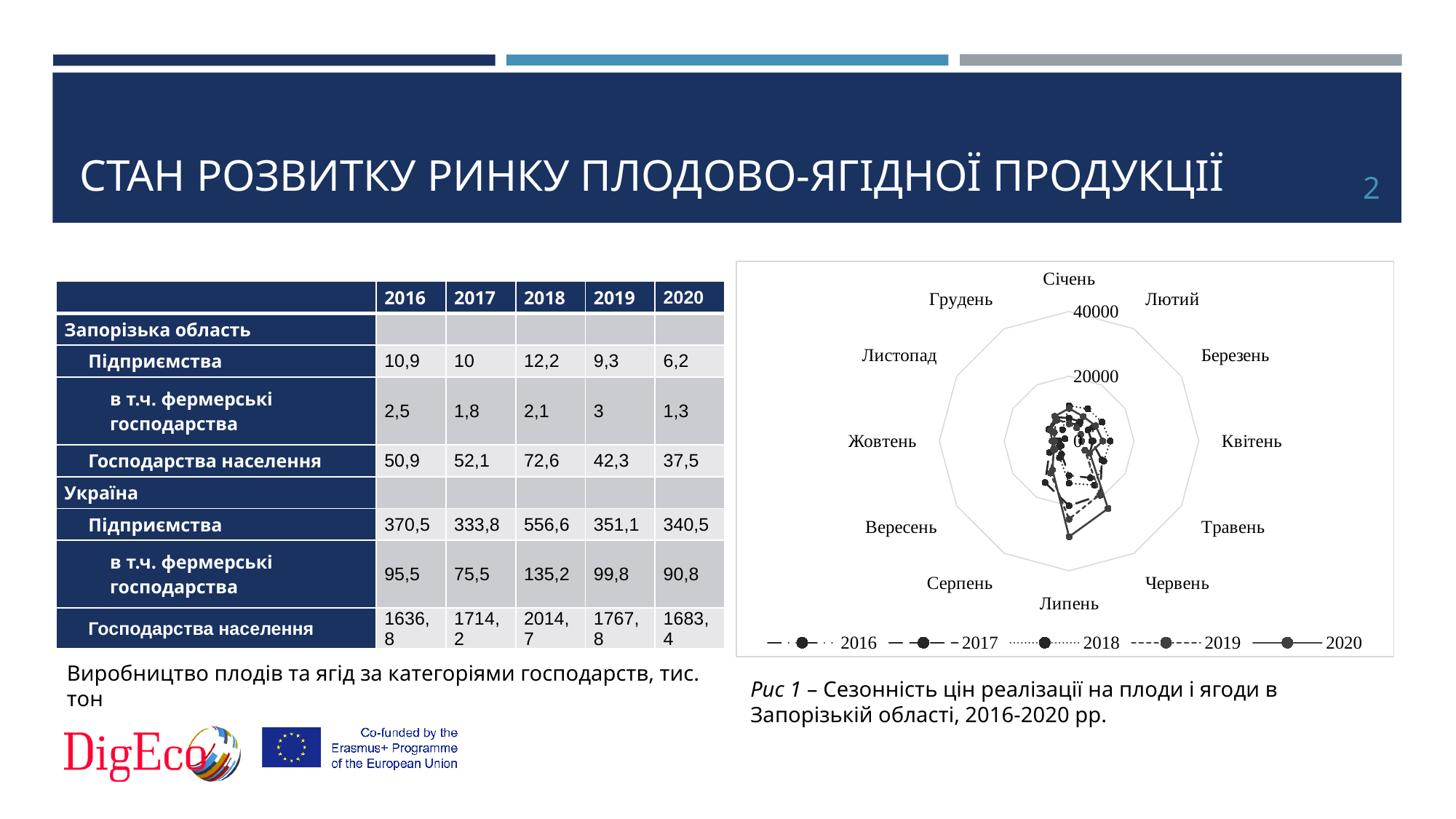
What kind of chart is shown on the right side of the slide? radar chart Which years are listed in the legend of the radar chart? 2016, 2017, 2018, 2019, 2020 In the radar chart, is the value for Грудень in 2016 greater or less than 20000? less How many categories (months) are plotted around the radar chart? 12 How many series does the legend of the radar chart list? 5 In the radar chart, is the value for Липень in 2020 greater or less than 40000? less What is the highest value shown on the radial axis of the radar chart? 40000 In the radar chart, is the value for Жовтень in 2018 greater or less than 20000? less